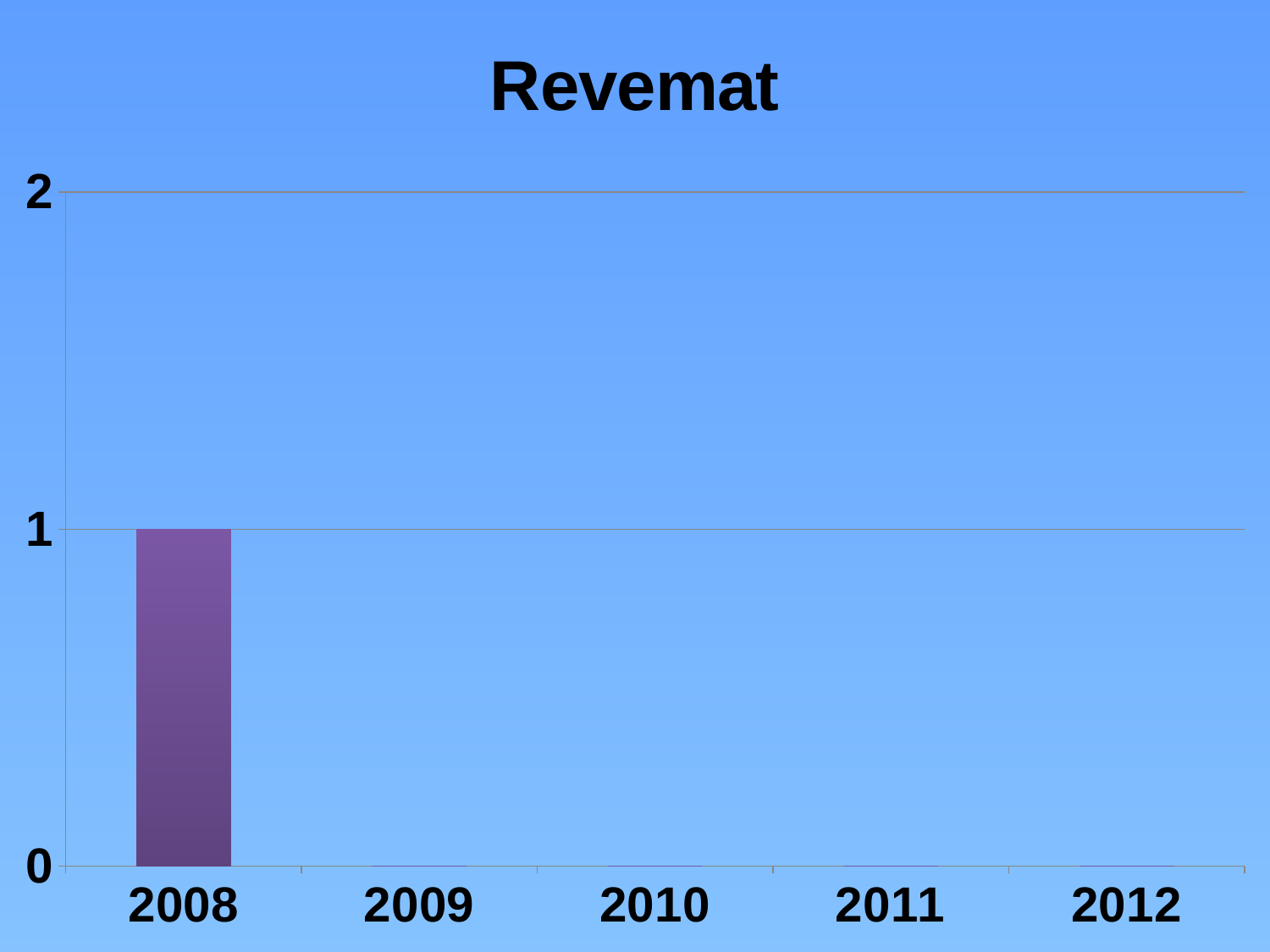
What is the title of the chart? Revemat What is the value for 2008? 1 Which is larger, the value for 2008 or the value for 2009? 2008 Which year has the highest value? 2008 Is the value for 2008 greater or less than 2? less What is the first year shown on the x axis? 2008 What type of chart is shown on the slide? bar chart How many years are shown on the x axis? 5 What is the highest value labelled on the y axis? 2